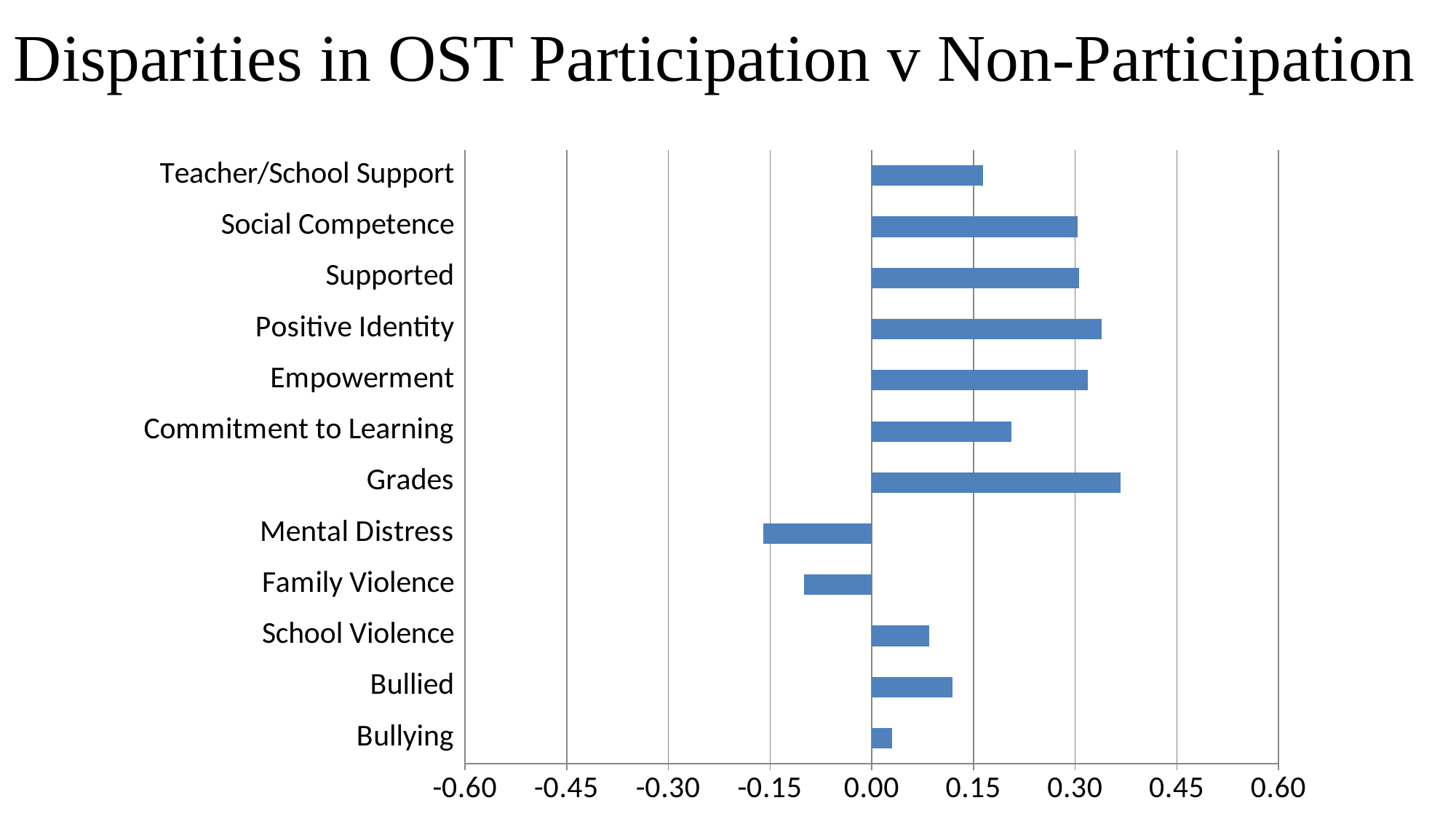
Is the value for Bullying greater or less than 0.15? less Is the value for Commitment to Learning greater or less than 0.15? greater Which category has the lowest value? Mental Distress What is the title of the chart? Disparities in OST Participation v Non-Participation Is the value for Mental Distress greater or less than 0.00? less Which is larger, the value for Social Competence or the value for Commitment to Learning? Social Competence Which category has the highest value? Grades How many categories are plotted on the chart? 12 What kind of chart is shown on the slide? bar chart How many categories have a negative value? 2 Which is larger, the value for Bullied or the value for Bullying? Bullied